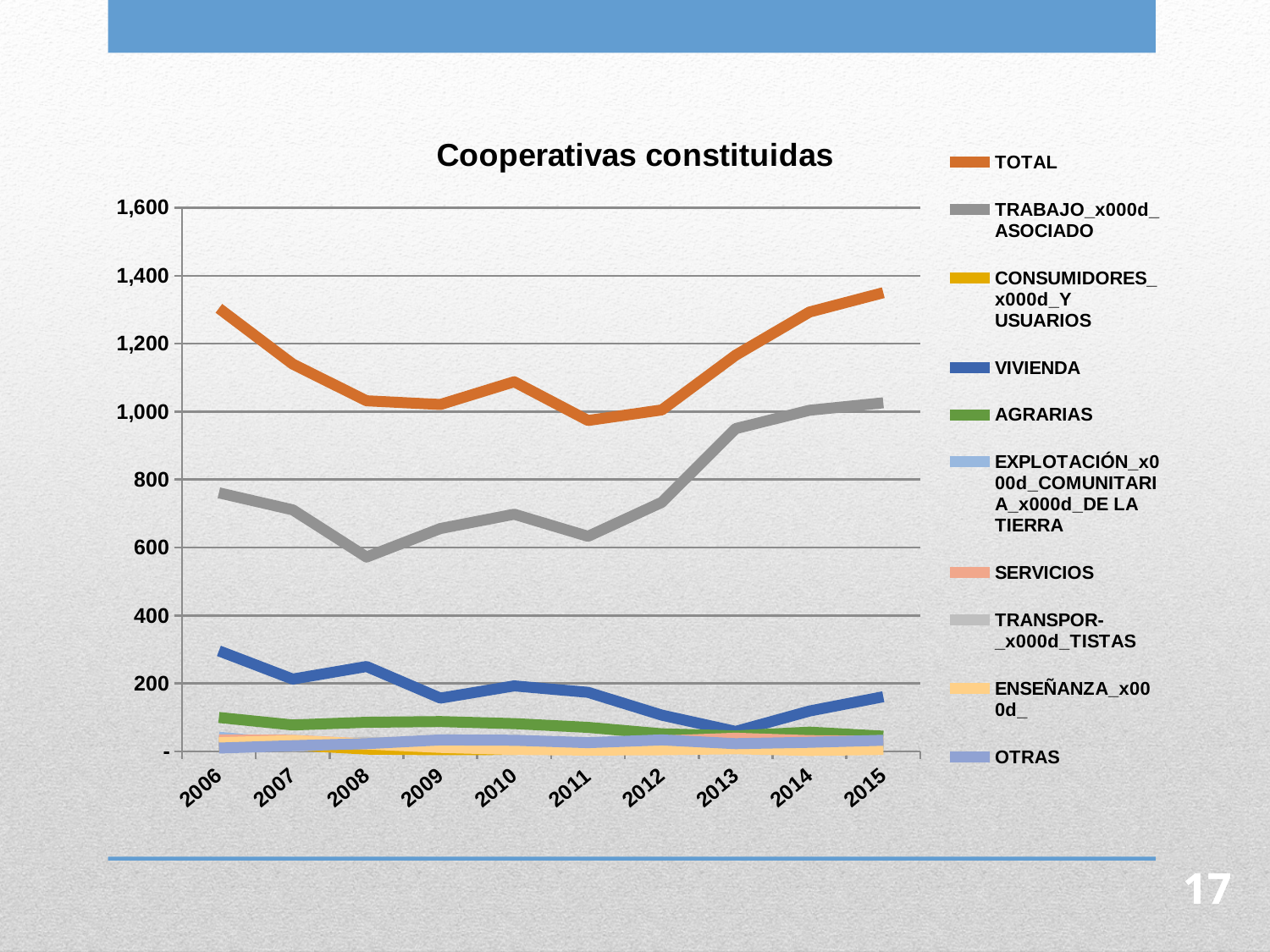
Which is larger in 2006, TOTAL or TRABAJO ASOCIADO? TOTAL In which year does the TRABAJO ASOCIADO series reach its lowest value? 2008 Is the value of VIVIENDA in 2006 greater or less than 200? greater In which year does the TOTAL series reach its highest value? 2015 What kind of chart is shown on the slide? Line chart Is the value of TOTAL in 2015 greater or less than 1,200? greater Does the TOTAL series rise or fall from 2012 to 2015? rise Is the value of TRABAJO ASOCIADO in 2008 greater or less than 600? less What is the title of the chart? Cooperativas constituidas How many years are shown along the x axis? 10 How many series does the legend list? 10